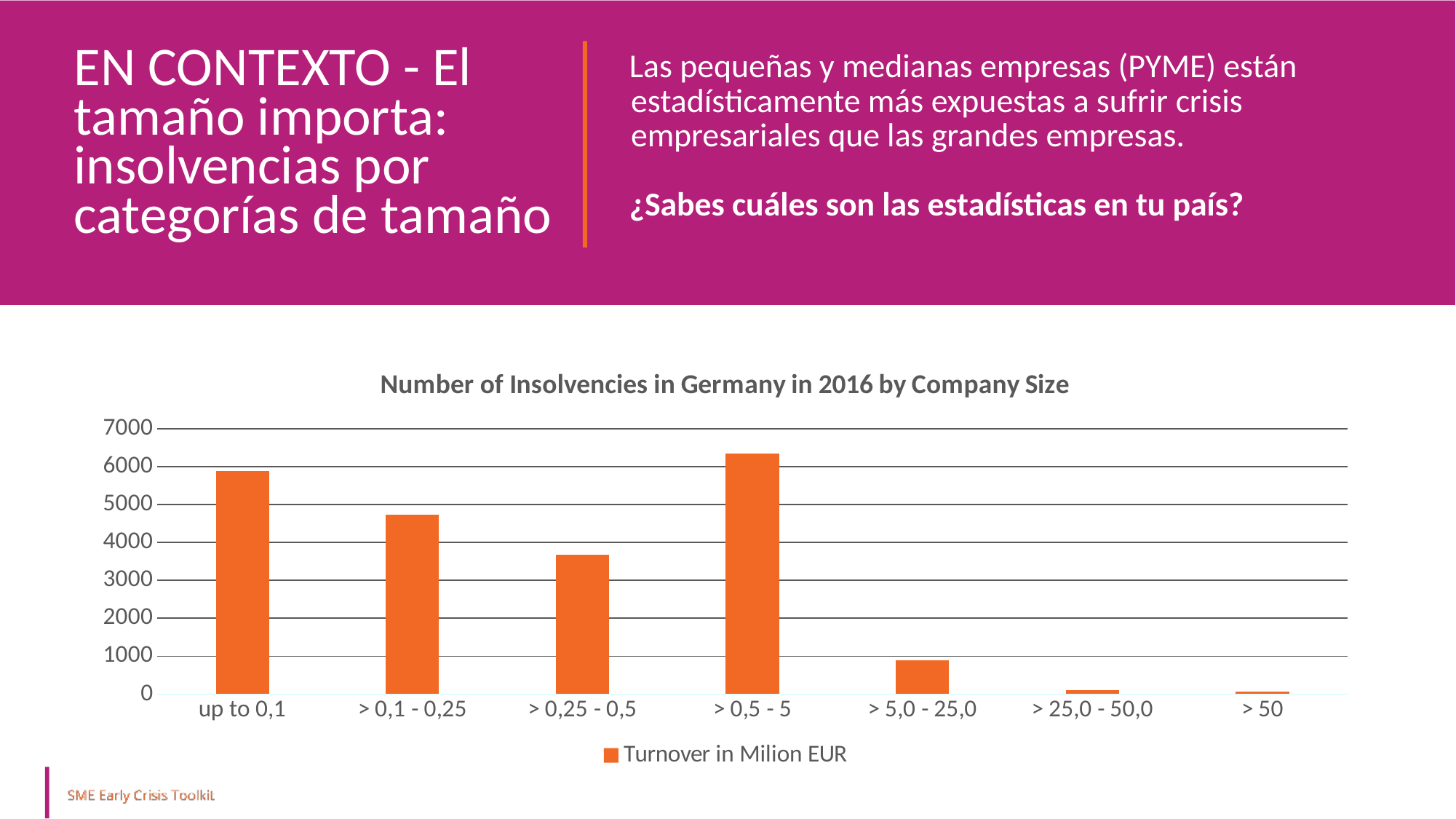
What kind of chart is shown on the slide? bar chart What is the series name shown in the chart legend? Turnover in Milion EUR Which has more insolvencies, 'up to 0,1' or '> 0,1 - 0,25'? up to 0,1 Is the value for '> 0,25 - 0,5' greater or less than 3000? greater What is the title of the chart? Number of Insolvencies in Germany in 2016 by Company Size Is the value for '> 5,0 - 25,0' greater or less than 1000? less Which company size category has the highest number of insolvencies? > 0,5 - 5 Is the value for 'up to 0,1' greater or less than 5000? greater How many series does the chart legend list? 1 How many company size categories are shown on the x axis of the chart? 7